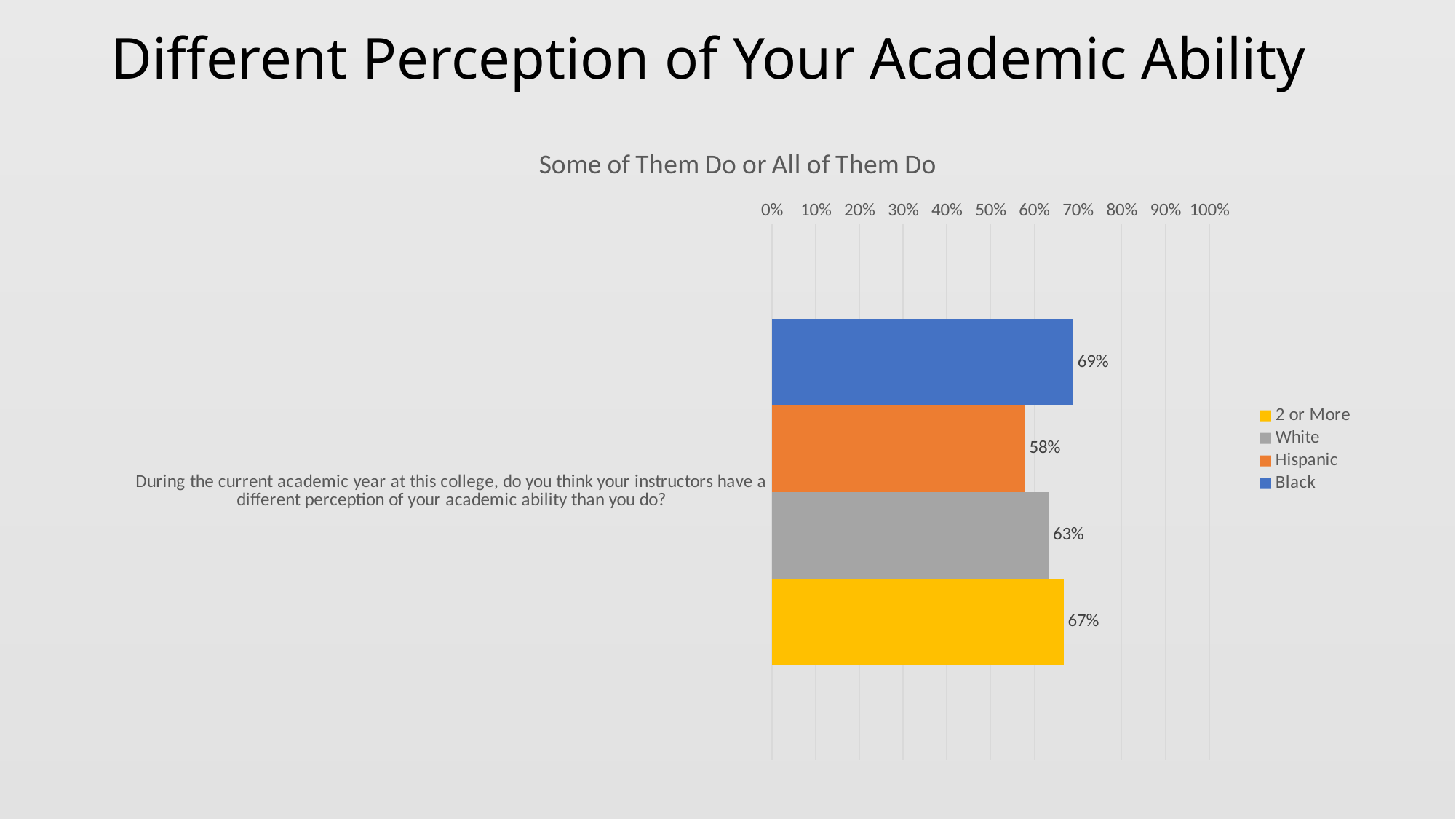
What is the value for Hispanic? 58% What is the value for 2 or More? 67% What is the difference between the values for Black and Hispanic? 11% What is the difference between the values for 2 or More and White? 4% What is the value for White? 63% What is the value for Black? 69% What kind of chart is shown? Bar chart Which group has the highest value? Black What is the title of the chart? Some of Them Do or All of Them Do How many series does the legend list? 4 Which group has the lowest value? Hispanic Which is larger, the value for White or the value for Hispanic? White